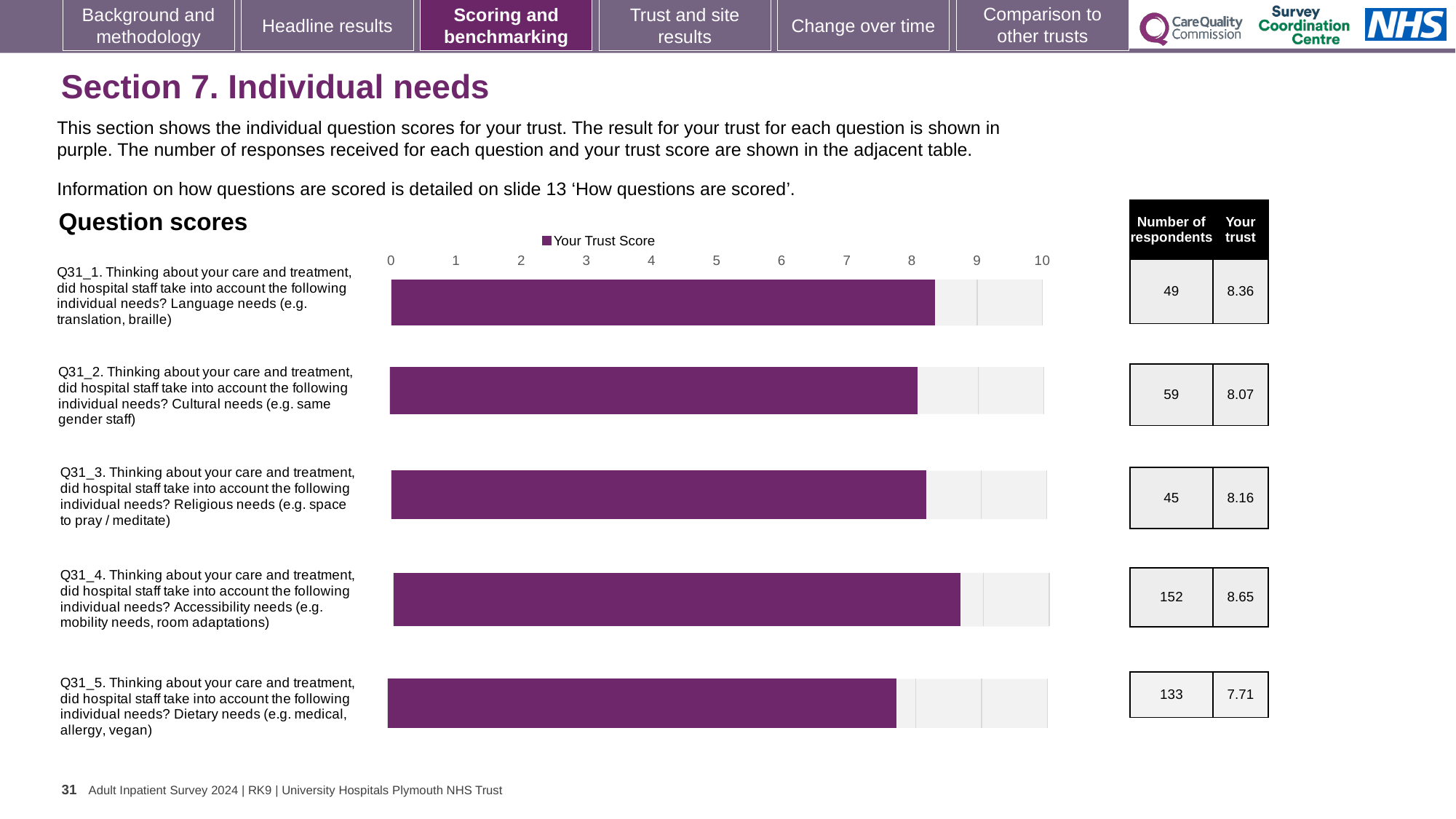
Which has a higher trust score, Q31_2 (Cultural needs) or Q31_3 (Religious needs)? Q31_3 (Religious needs) What is the trust score for Q31_5 (Dietary needs)? 7.71 What is the name of the series shown in the chart legend? Your Trust Score What is the difference between the trust scores for Q31_4 and Q31_5? 0.94 How many series does the chart legend list? 1 Is the trust score for Q31_5 (Dietary needs) greater or less than 8? less What is the trust score for Q31_1 (Language needs)? 8.36 Which question has the lowest trust score? Q31_5 (Dietary needs) How many respondents answered Q31_4 (Accessibility needs)? 152 What kind of chart is shown on the slide? Bar chart How many questions are plotted in the chart? 5 Which question has the highest trust score? Q31_4 (Accessibility needs)